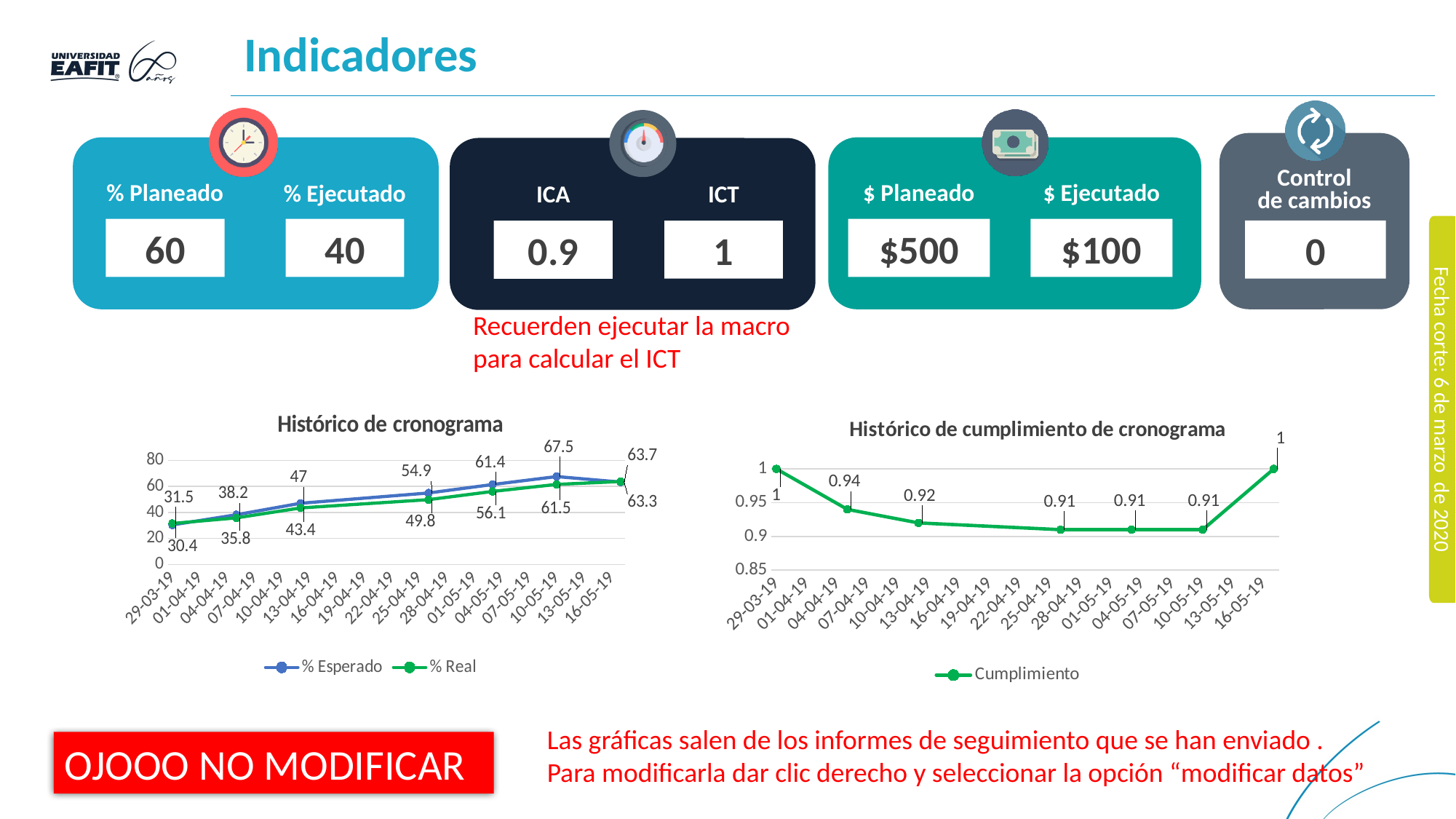
How many series does the legend of 'Histórico de cronograma' list? 2 How many series does the legend of 'Histórico de cumplimiento de cronograma' list? 1 In 'Histórico de cumplimiento de cronograma', what is the Cumplimiento value at 29-03-19? 1 In 'Histórico de cronograma', what is the highest value of the % Esperado series? 67.5 In 'Histórico de cronograma', what is the % Real value at the last date, 16-05-19? 63.7 What kind of chart is 'Histórico de cronograma'? line chart In 'Histórico de cronograma', do the % Real values generally rise or fall from left to right? rise In 'Histórico de cronograma', what is the difference between % Esperado and % Real at the last date, 16-05-19? 0.4 What are the two series named in the legend of 'Histórico de cronograma'? % Esperado and % Real In 'Histórico de cumplimiento de cronograma', what is the lowest Cumplimiento value shown? 0.91 In 'Histórico de cronograma', what is the % Esperado value at the first date, 29-03-19? 30.4 In 'Histórico de cronograma', what is the lowest value of the % Real series? 31.5